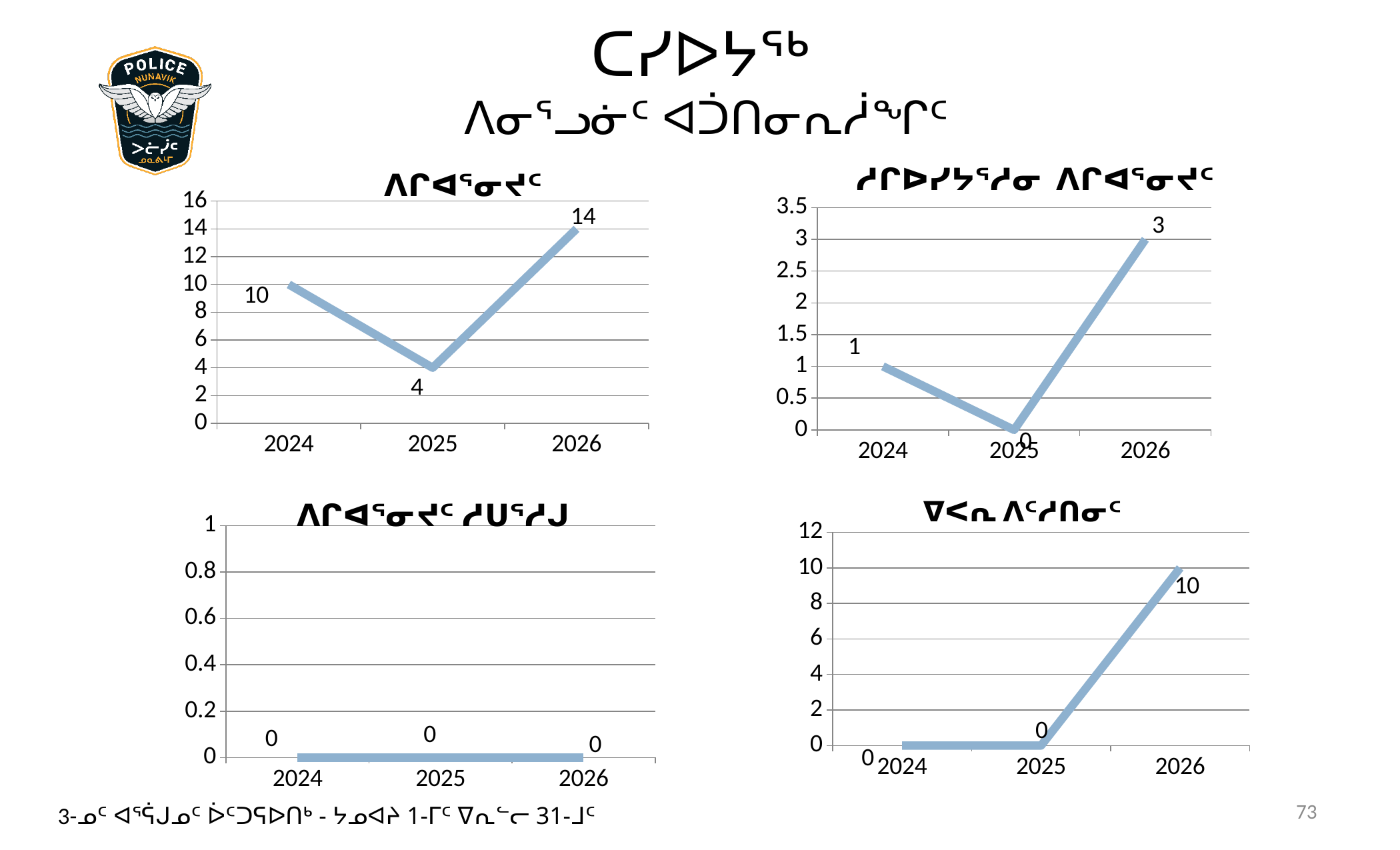
In the top-left chart, what is the value for 2025? 4 In the bottom-right chart, what is the value for 2026? 10 In the bottom-left chart, what is the value for 2025? 0 In the top-left chart, what is the difference between the values for 2026 and 2024? 4 In the top-right chart, what is the value for 2026? 3 How many years are plotted on the x axis of the bottom-right chart? 3 In the top-right chart, which year has the lowest value? 2025 In the top-left chart, does the value rise or fall from 2025 to 2026? rise In the bottom-right chart, what is the difference between the values for 2026 and 2025? 10 In the top-right chart, is the value for 2024 larger or smaller than the value for 2026? smaller What kind of chart is the top-left chart? line chart In the top-left chart, which year has the highest value? 2026